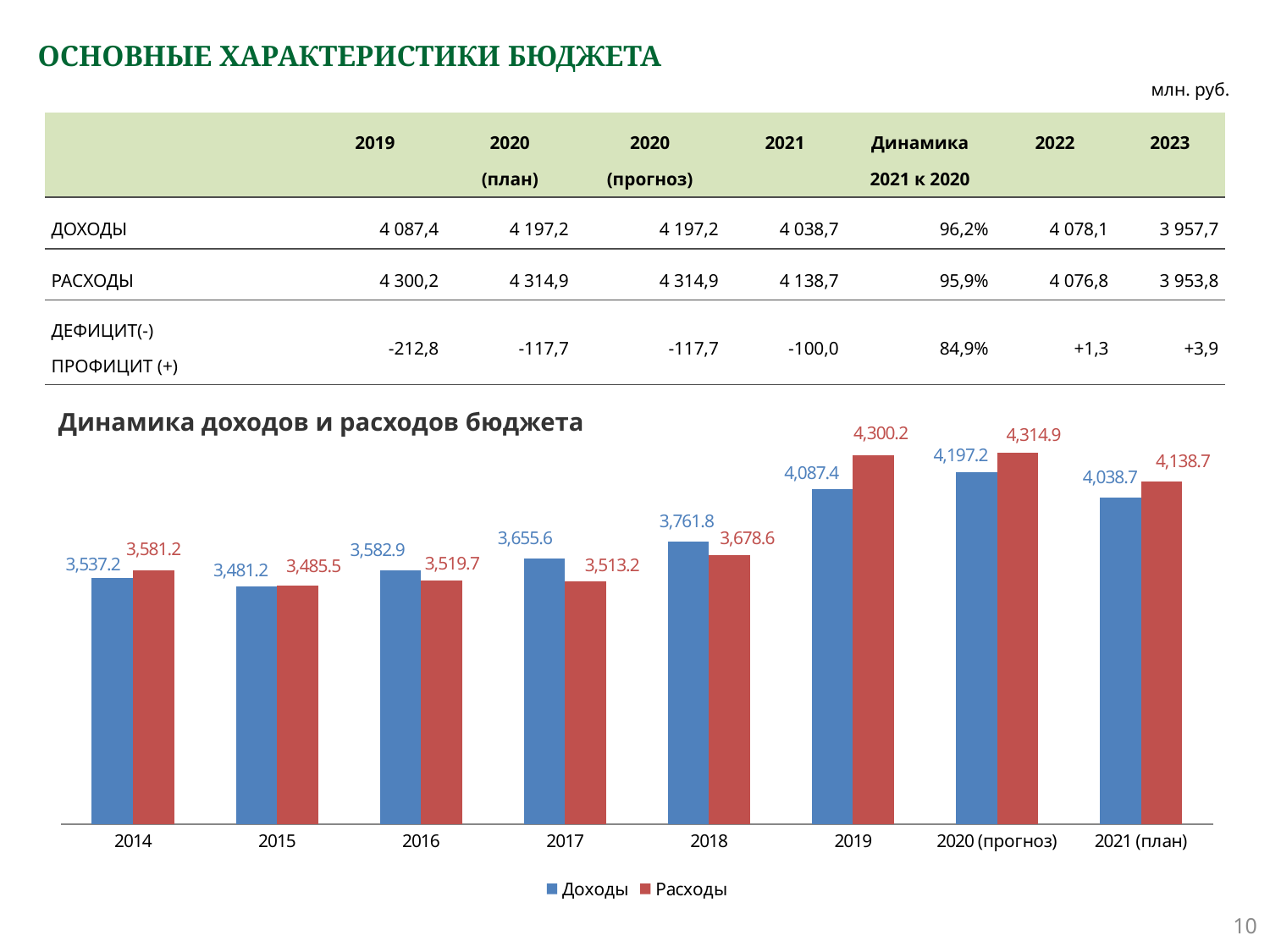
In the chart 'Динамика доходов и расходов бюджета', what is the value of Расходы for 2017? 3,513.2 In the chart 'Динамика доходов и расходов бюджета', what is the difference between Доходы and Расходы in 2017? 142.4 In the chart 'Динамика доходов и расходов бюджета', what is the value of Доходы for 2019? 4,087.4 What type of chart is 'Динамика доходов и расходов бюджета'? Bar chart How many years are shown on the x axis of the chart 'Динамика доходов и расходов бюджета'? 8 In the chart 'Динамика доходов и расходов бюджета', which year has the highest Расходы value? 2020 (прогноз) How many series does the legend of the chart 'Динамика доходов и расходов бюджета' list? 2 In the chart 'Динамика доходов и расходов бюджета', which is larger in 2016, Доходы or Расходы? Доходы In the chart 'Динамика доходов и расходов бюджета', do the Доходы values rise or fall from 2015 to 2020 (прогноз)? Rise In the chart 'Динамика доходов и расходов бюджета', what is the value of Доходы for 2021 (план)? 4,038.7 In the chart 'Динамика доходов и расходов бюджета', what is the difference between Расходы and Доходы in 2019? 212.8 In the chart 'Динамика доходов и расходов бюджета', which year has the lowest Доходы value? 2015